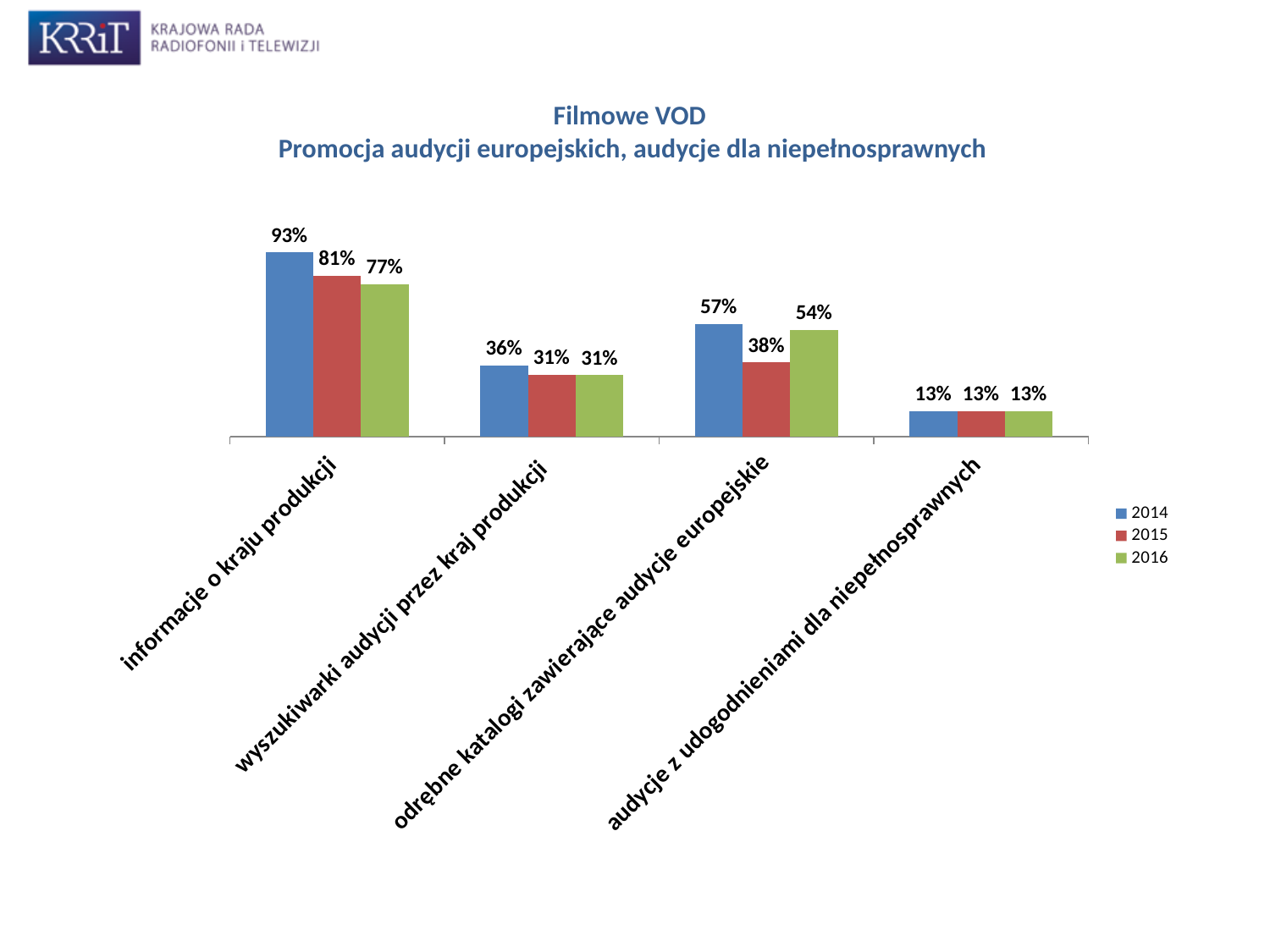
How many series does the legend list? 3 What kind of chart is shown on the slide? bar chart What is the difference between the 2014 and 2016 values for "informacje o kraju produkcji"? 16% Which category has the highest 2014 value? informacje o kraju produkcji Which is larger: the 2016 value for "odrębne katalogi zawierające audycje europejskie" or the 2016 value for "wyszukiwarki audycji przez kraj produkcji"? odrębne katalogi zawierające audycje europejskie What is the 2014 value for "informacje o kraju produkcji"? 93% What is the difference between the 2014 and 2015 values for "odrębne katalogi zawierające audycje europejskie"? 19% Do the values for "informacje o kraju produkcji" rise or fall from 2014 to 2016? fall How many categories are shown on the x axis? 4 Which category has the lowest 2016 value? audycje z udogodnieniami dla niepełnosprawnych What is the 2016 value for "wyszukiwarki audycji przez kraj produkcji"? 31% What is the 2015 value for "odrębne katalogi zawierające audycje europejskie"? 38%